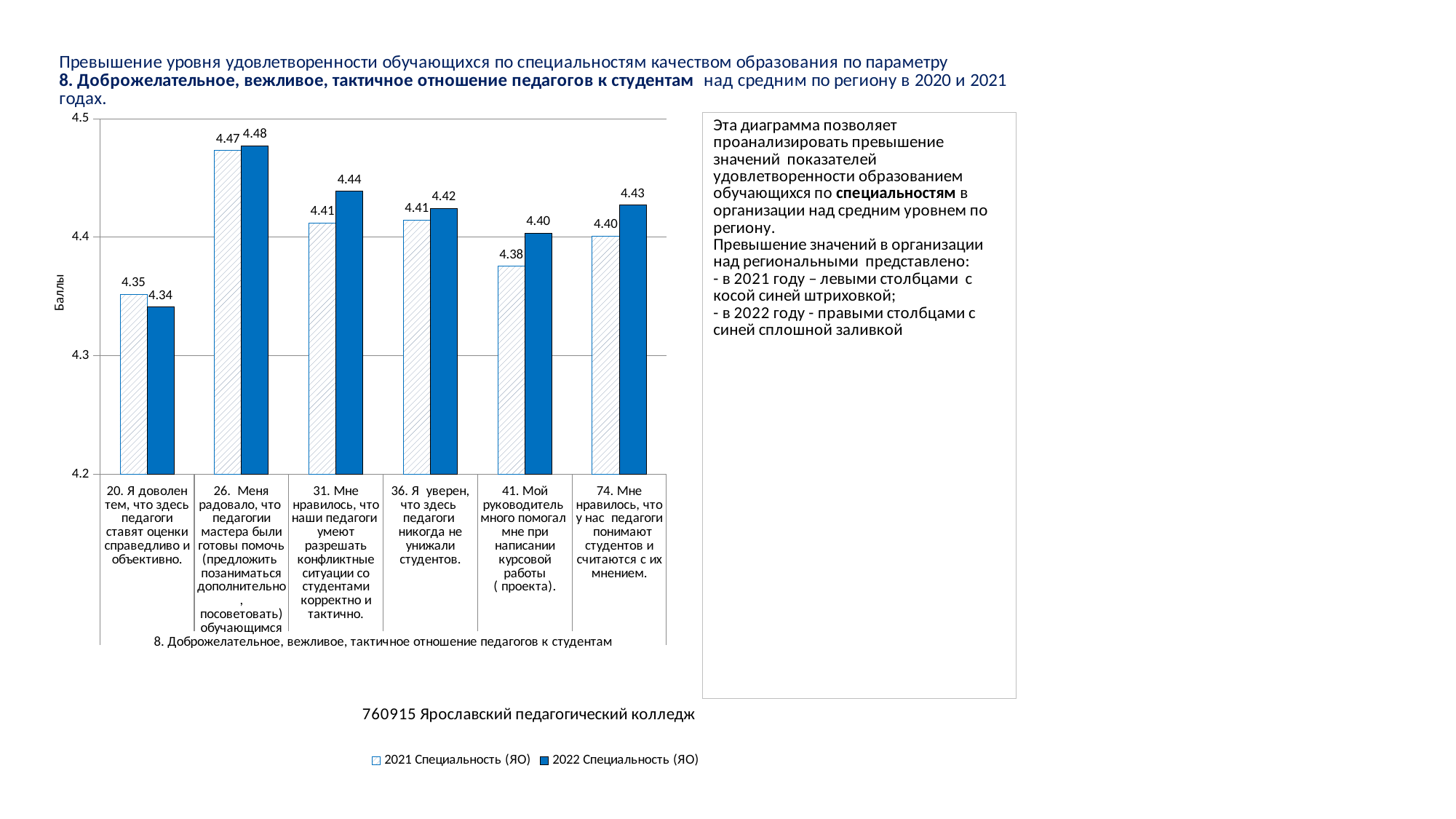
What kind of chart is shown on the slide? Bar chart How many categories are shown on the x axis of the chart? 6 What is the value of the 2021 Специальность (ЯО) series for category "74. Мне нравилось, что у нас педагоги понимают студентов и считаются с их мнением."? 4.40 Which category has the highest value in the 2022 Специальность (ЯО) series? 26. Меня радовало, что педагоги мастера были готовы помочь (предложить позаниматься дополнительно, посоветовать) обучающимся What is the value of the 2022 Специальность (ЯО) series for category "26. Меня радовало, что педагоги мастера были готовы помочь..."? 4.48 What is the difference between the 2022 and 2021 values for category "31. Мне нравилось, что наши педагоги умеют разрешать конфликтные ситуации со студентами корректно и тактично."? 0.03 What is the title of the vertical axis of the chart? Баллы How many series does the chart legend list? 2 Is the 2021 Специальность (ЯО) value for category "36. Я уверен, что здесь педагоги никогда не унижали студентов." greater or less than 4.4? greater What is the value of the 2021 Специальность (ЯО) series for category "41. Мой руководитель много помогал мне при написании курсовой работы (проекта)."? 4.38 Which category has the lowest value in the 2021 Специальность (ЯО) series? 20. Я доволен тем, что здесь педагоги ставят оценки справедливо и объективно. For category "20. Я доволен тем, что здесь педагоги ставят оценки справедливо и объективно.", which series has the larger value, 2021 Специальность (ЯО) or 2022 Специальность (ЯО)? 2021 Специальность (ЯО)